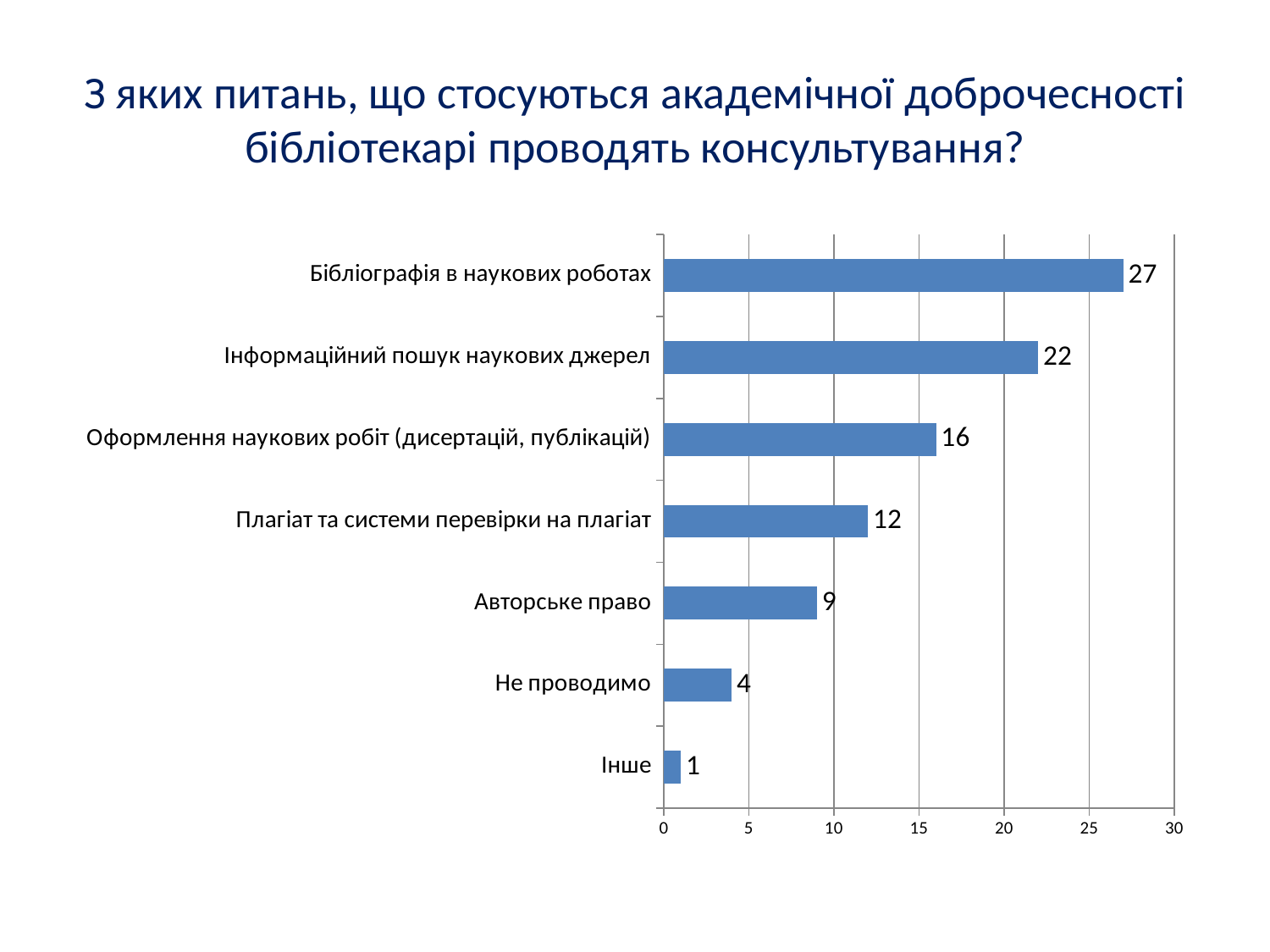
Which category has the lowest value? Інше What is the maximum value shown on the horizontal axis? 30 What kind of chart is shown on the slide? bar chart How many categories are shown in the chart? 7 Is the value for "Інформаційний пошук наукових джерел" greater or less than 20? greater What is the value for "Не проводимо"? 4 What is the value for "Бібліографія в наукових роботах"? 27 Which category has the highest value? Бібліографія в наукових роботах What is the difference between the values for "Інформаційний пошук наукових джерел" and "Плагіат та системи перевірки на плагіат"? 10 What is the difference between the highest and lowest values in the chart? 26 Which is larger: the value for "Оформлення наукових робіт (дисертацій, публікацій)" or the value for "Плагіат та системи перевірки на плагіат"? Оформлення наукових робіт (дисертацій, публікацій) What is the value for "Авторське право"? 9